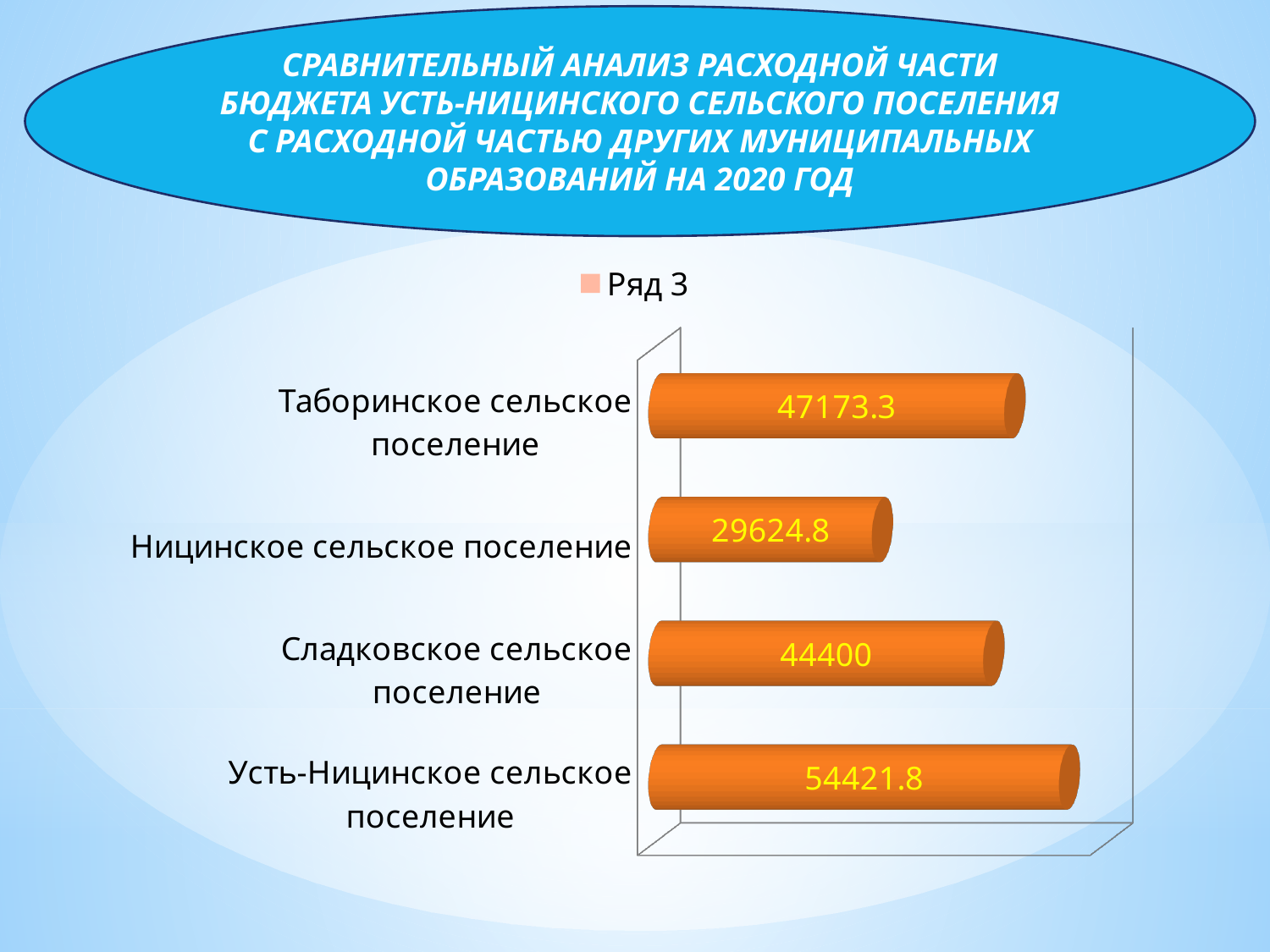
What is the value for Усть-Ницинское сельское поселение? 54421.8 What is the difference between the values for Таборинское сельское поселение and Сладковское сельское поселение? 2773.3 What is the value for Таборинское сельское поселение? 47173.3 Which settlement has the highest value? Усть-Ницинское сельское поселение What kind of chart is shown on the slide? Bar chart What is the name of the series shown in the legend? Ряд 3 What is the value for Сладковское сельское поселение? 44400 Which is larger, the value for Таборинское сельское поселение or Сладковское сельское поселение? Таборинское сельское поселение What is the difference between the values for Усть-Ницинское сельское поселение and Ницинское сельское поселение? 24797 What is the value for Ницинское сельское поселение? 29624.8 Which settlement has the lowest value? Ницинское сельское поселение How many settlements are shown in the chart? 4